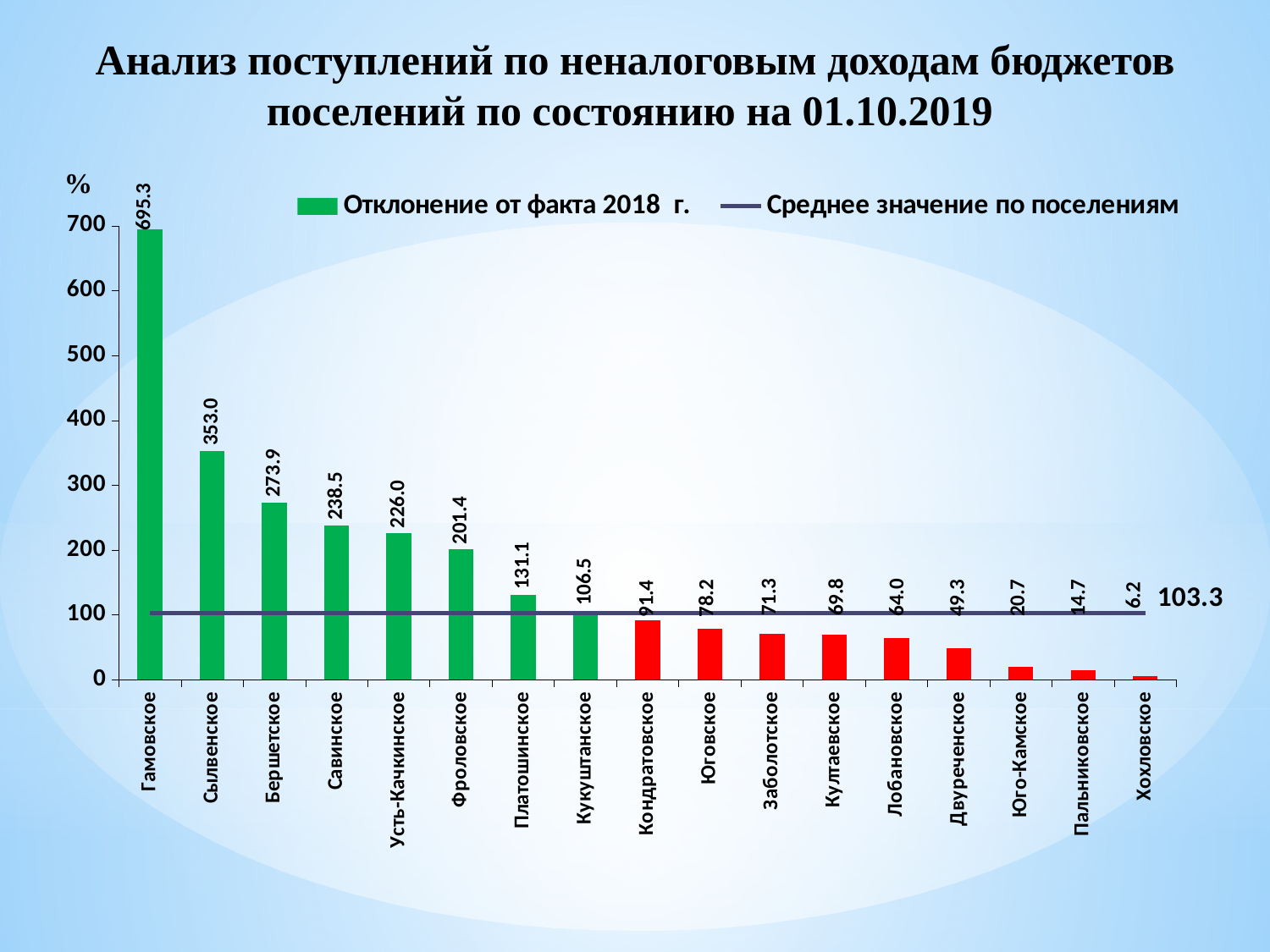
Which settlement has the lowest value? Хохловское What is the difference between the values for Сылвенское and Бершетское? 79.1 What is the value for Фроловское? 201.4 What is the value for Гамовское? 695.3 Which is larger, the value for Юговское or the value for Заболотское? Юговское Which settlement has the highest value? Гамовское What is the value of the average line (Среднее значение по поселениям)? 103.3 What kind of chart is shown on the slide? combination bar and line chart How many entries does the legend list? 2 Is the value for Платошинское greater or less than 100? greater How many settlements are shown on the x axis? 17 What is the value for Хохловское? 6.2